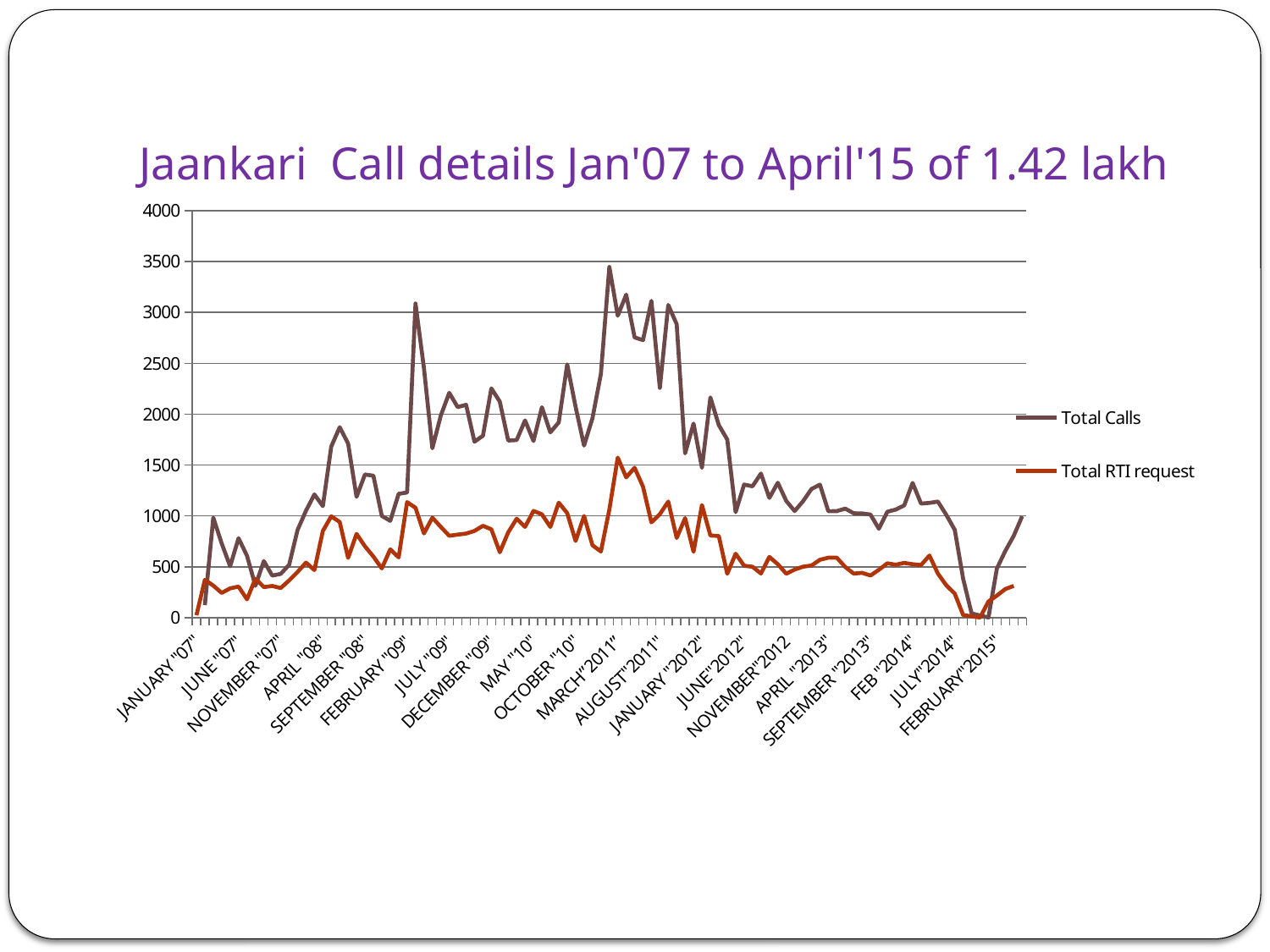
How many series does the legend list? 2 Is the value of Total RTI request at APRIL "2013" greater or less than 1000? less Is the value of Total Calls at JULY "09" greater or less than 1500? greater Does the Total Calls series generally rise or fall from AUGUST"2011" to JUNE"2012"? Fall Which two series are listed in the legend? Total Calls and Total RTI request At MARCH"2011", which series has the larger value, Total Calls or Total RTI request? Total Calls What is the title of the chart? Jaankari Call details Jan'07 to April'15 of 1.42 lakh What kind of chart is shown on the slide? Line chart Is the value of Total RTI request at MARCH"2011" greater or less than 1000? greater